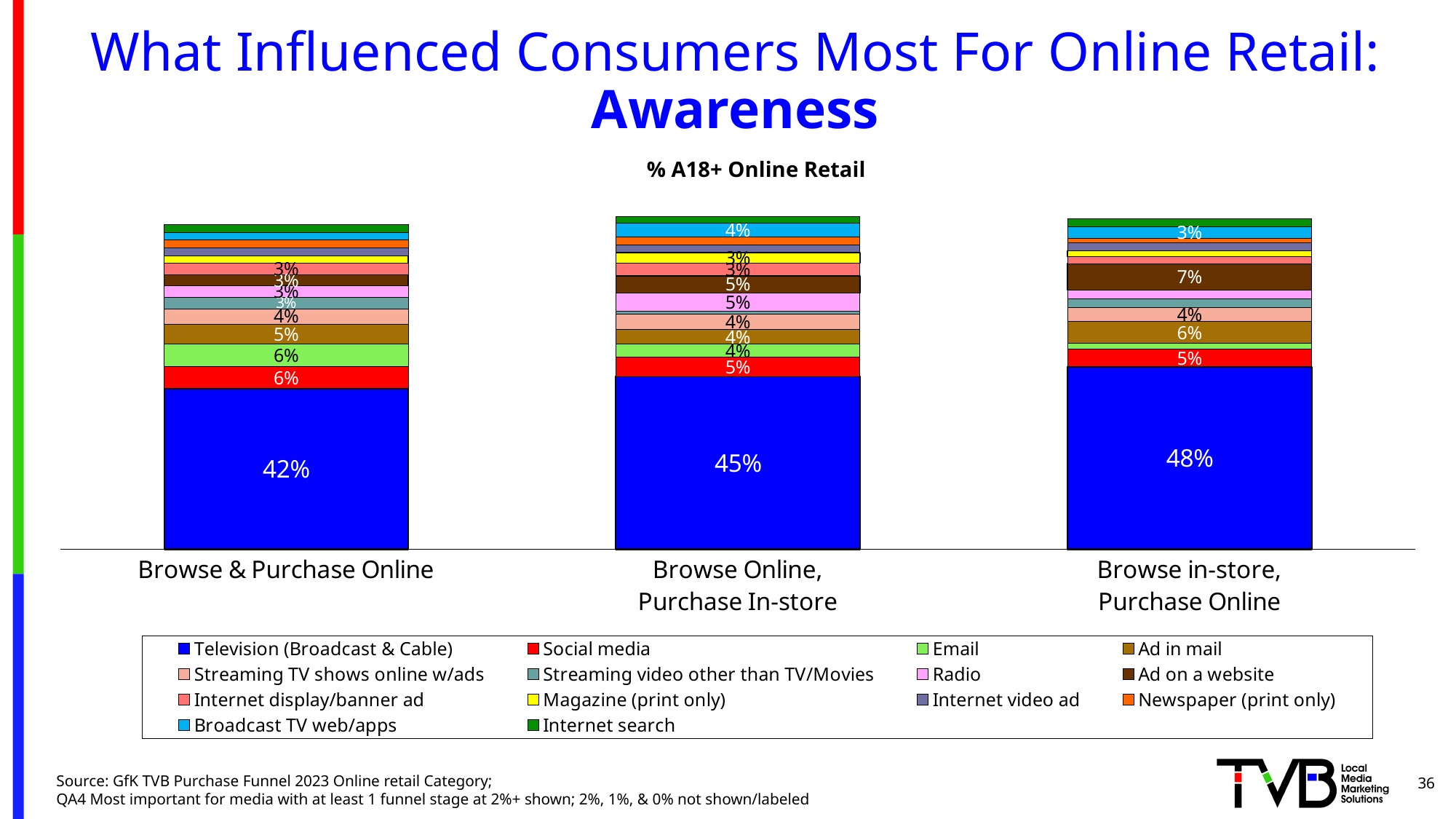
What kind of chart is shown on the slide? Stacked bar chart What is the value for Television (Broadcast & Cable) in the Browse in-store, Purchase Online bar? 48% Which is larger: Ad in mail for Browse in-store, Purchase Online or Ad in mail for Browse & Purchase Online? Browse in-store, Purchase Online What is the difference between the Television (Broadcast & Cable) values for Browse in-store, Purchase Online and Browse & Purchase Online? 6% What is the title shown above the chart? % A18+ Online Retail How many categories (bars) are shown on the x axis? 3 What is the value for Television (Broadcast & Cable) in the Browse & Purchase Online bar? 42% What is the value for Social media in the Browse Online, Purchase In-store bar? 5% Which category has the lowest Television (Broadcast & Cable) value? Browse & Purchase Online Which category has the highest Television (Broadcast & Cable) value? Browse in-store, Purchase Online What is the value for Ad on a website in the Browse in-store, Purchase Online bar? 7% How many series does the legend list? 14